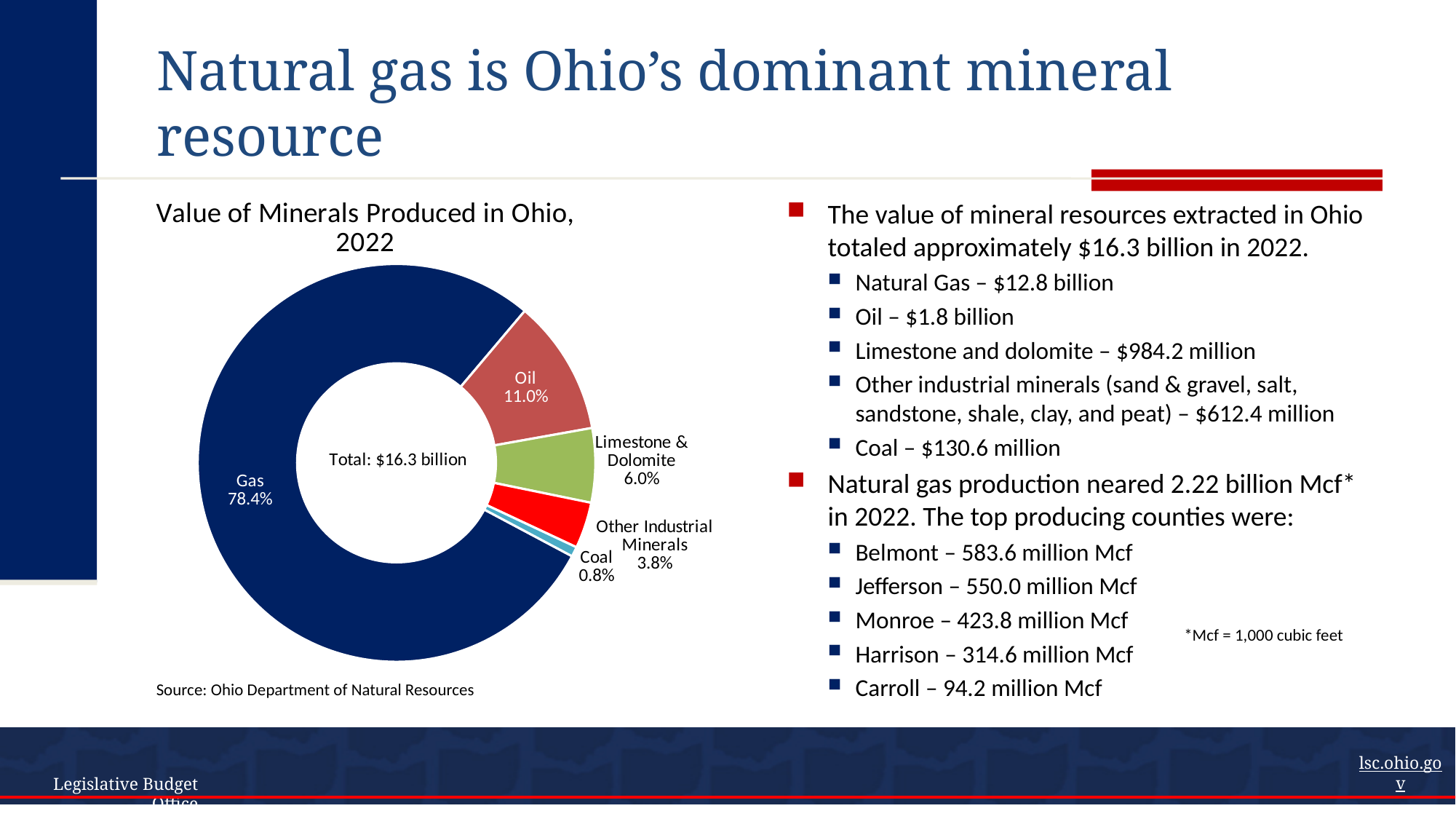
What share of the value of minerals produced in Ohio in 2022 does Gas account for? 78.4% What is the share for Coal? 0.8% What is the difference in percentage points between Oil and Limestone & Dolomite? 5.0 percentage points What percentage of the chart is Oil? 11.0% What percentage does Other Industrial Minerals represent? 3.8% How many categories are shown in the chart? 5 Which is larger, the share for Other Industrial Minerals or the share for Coal? Other Industrial Minerals Which category has the largest share of the chart? Gas What kind of chart is shown on the slide? Doughnut (pie) chart Which category has the smallest share of the chart? Coal What is the share for Limestone & Dolomite? 6.0% What total value is printed in the center of the chart? Total: $16.3 billion